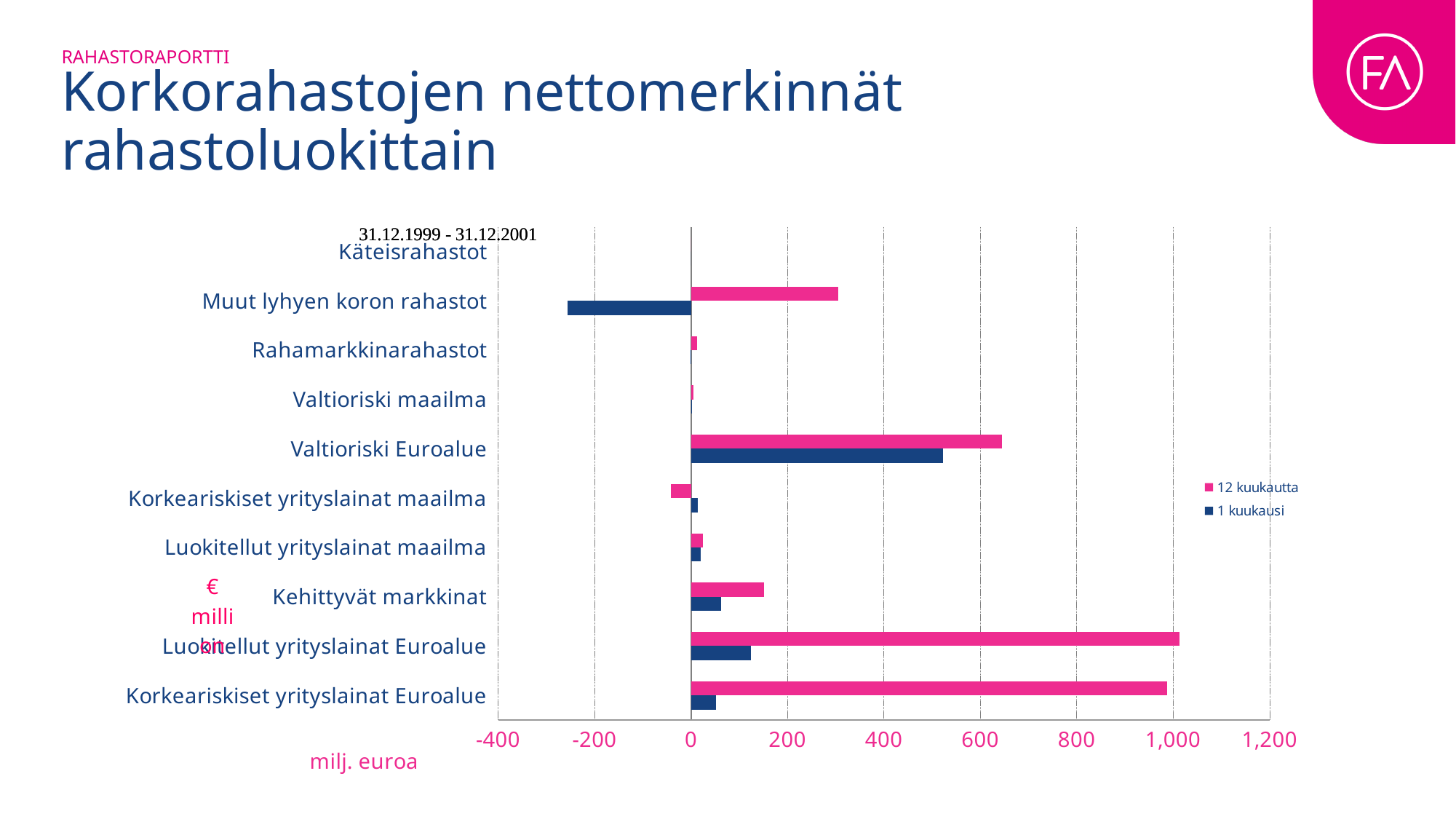
Which category has the lowest value for the 12 kuukautta series? Korkeariskiset yrityslainat maailma Which category has the lowest value for the 1 kuukausi series? Muut lyhyen koron rahastot Which category has the highest value for the 1 kuukausi series? Valtioriski Euroalue Is the 1 kuukausi value for Muut lyhyen koron rahastot greater or less than -200? less Is the 12 kuukautta value for Kehittyvät markkinat greater or less than 200? less Is the 12 kuukautta value for Valtioriski Euroalue greater or less than 600? greater What unit is shown on the x axis of the chart? milj. euroa For Valtioriski Euroalue, which series has the larger value, 12 kuukautta or 1 kuukausi? 12 kuukautta How many fund categories are shown on the chart? 10 How many series does the legend list? 2 What kind of chart is shown on the slide? bar chart